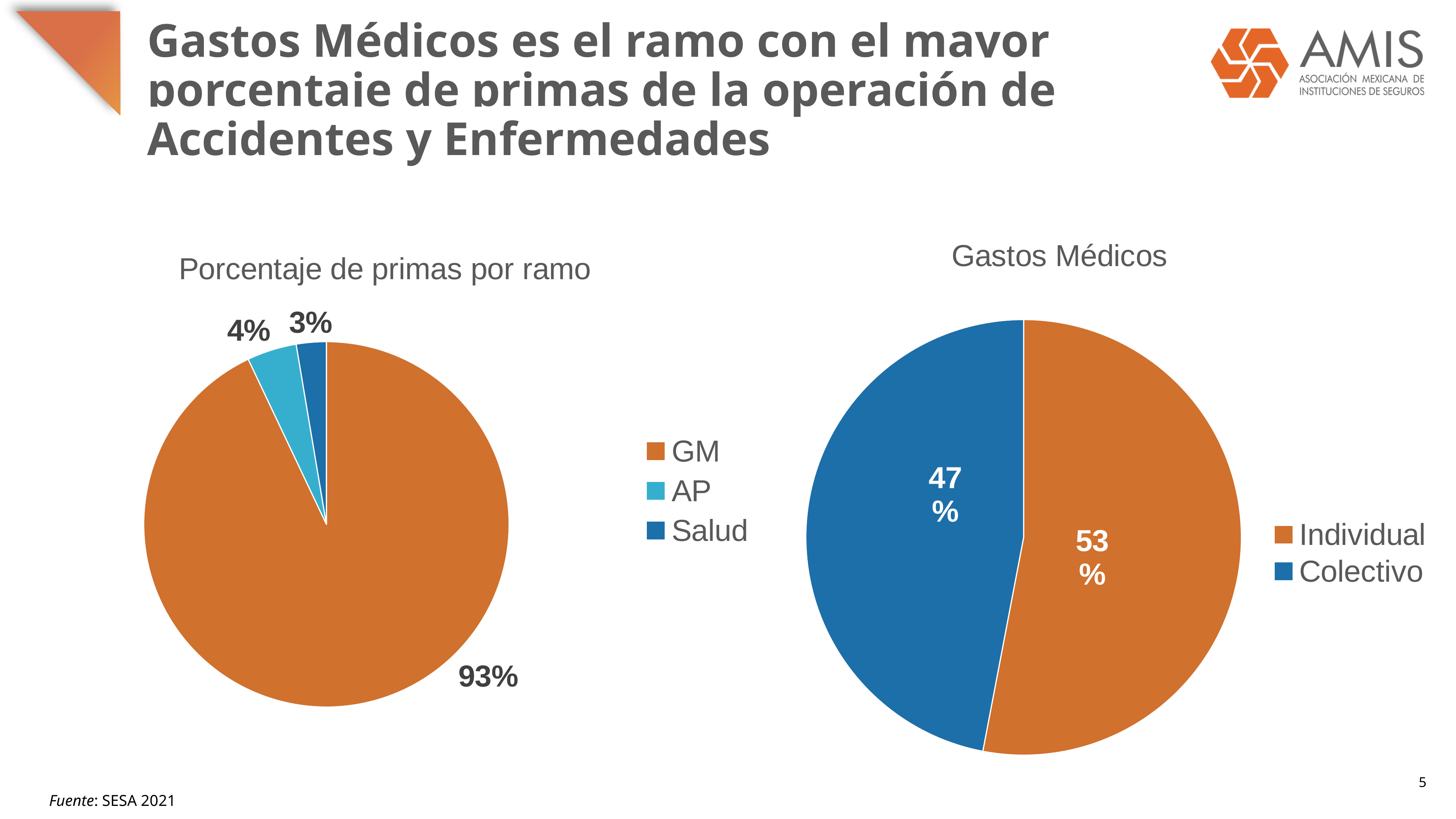
In the 'Porcentaje de primas por ramo' chart, what percentage does Salud account for? 3% In the 'Porcentaje de primas por ramo' chart, what percentage does AP account for? 4% In the 'Porcentaje de primas por ramo' chart, what percentage does GM account for? 93% What kind of chart is the 'Porcentaje de primas por ramo' chart? Pie chart What is the title of the chart on the right side of the slide? Gastos Médicos In the 'Gastos Médicos' chart, what percentage does Individual account for? 53% In the 'Porcentaje de primas por ramo' chart, which category has the largest share? GM In the 'Gastos Médicos' chart, which is larger, Individual or Colectivo? Individual In the 'Porcentaje de primas por ramo' chart, how many categories does the legend list? 3 In the 'Porcentaje de primas por ramo' chart, which category has the smallest share? Salud In the 'Gastos Médicos' chart, what is the difference in percentage points between Individual and Colectivo? 6 percentage points In the 'Gastos Médicos' chart, what percentage does Colectivo account for? 47%